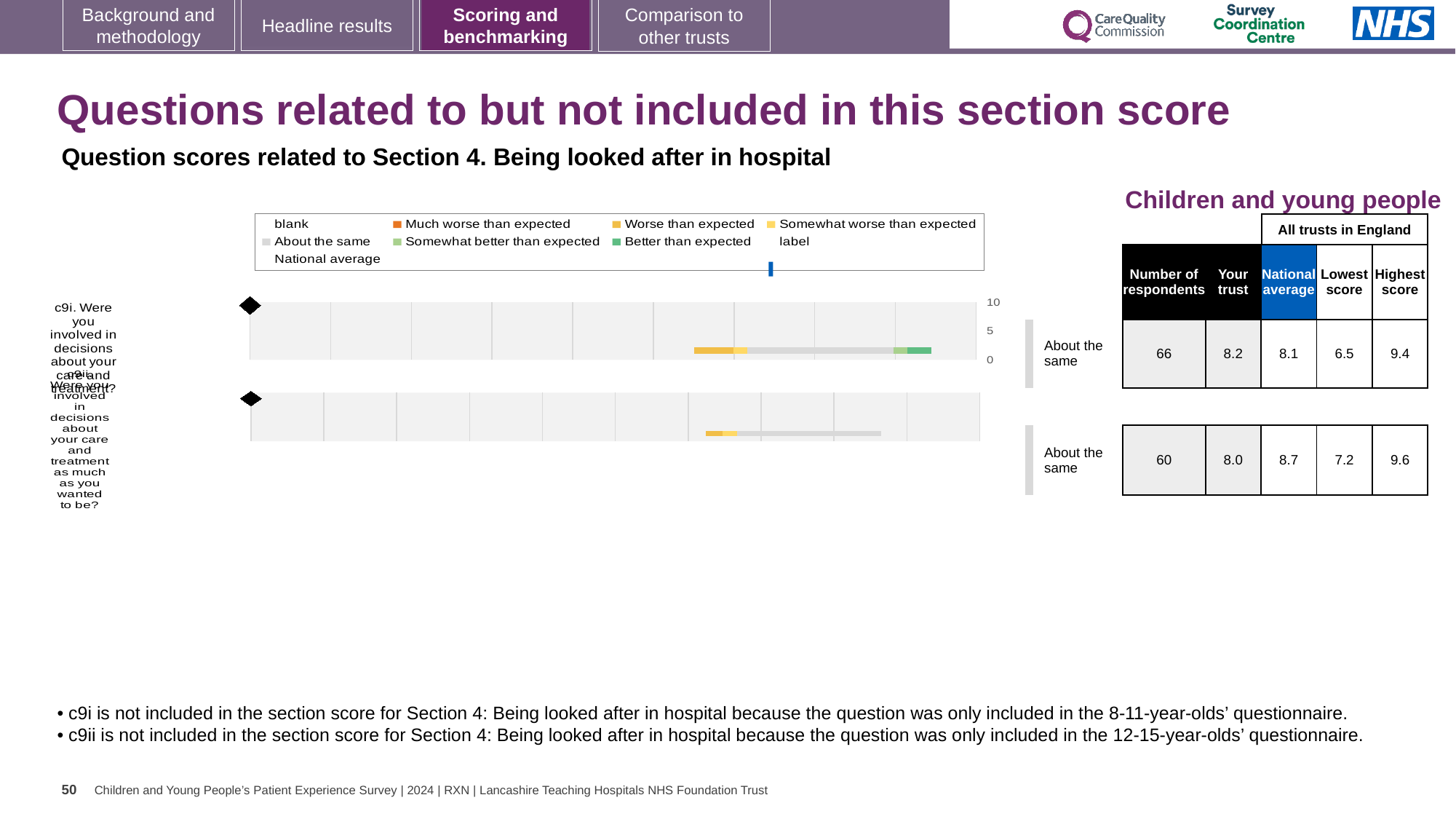
What is the number of respondents for question c9i? 66 What kind of chart is used to show the question scores for c9i and c9ii? bar chart What is the lowest score across all trusts in England for question c9i? 6.5 For question c9ii, which is larger: the 'Your trust' score or the national average? National average Which question has the higher number of respondents, c9i or c9ii? c9i How many questions are plotted in the chart? 2 How many more respondents answered c9i than c9ii? 6 What benchmark category is shown next to both c9i and c9ii? About the same What is the highest score across all trusts in England for question c9ii? 9.6 What is the difference between the highest and lowest scores for question c9i? 2.9 What is the 'Your trust' score for question c9ii? 8.0 What is the national average score for question c9i? 8.1